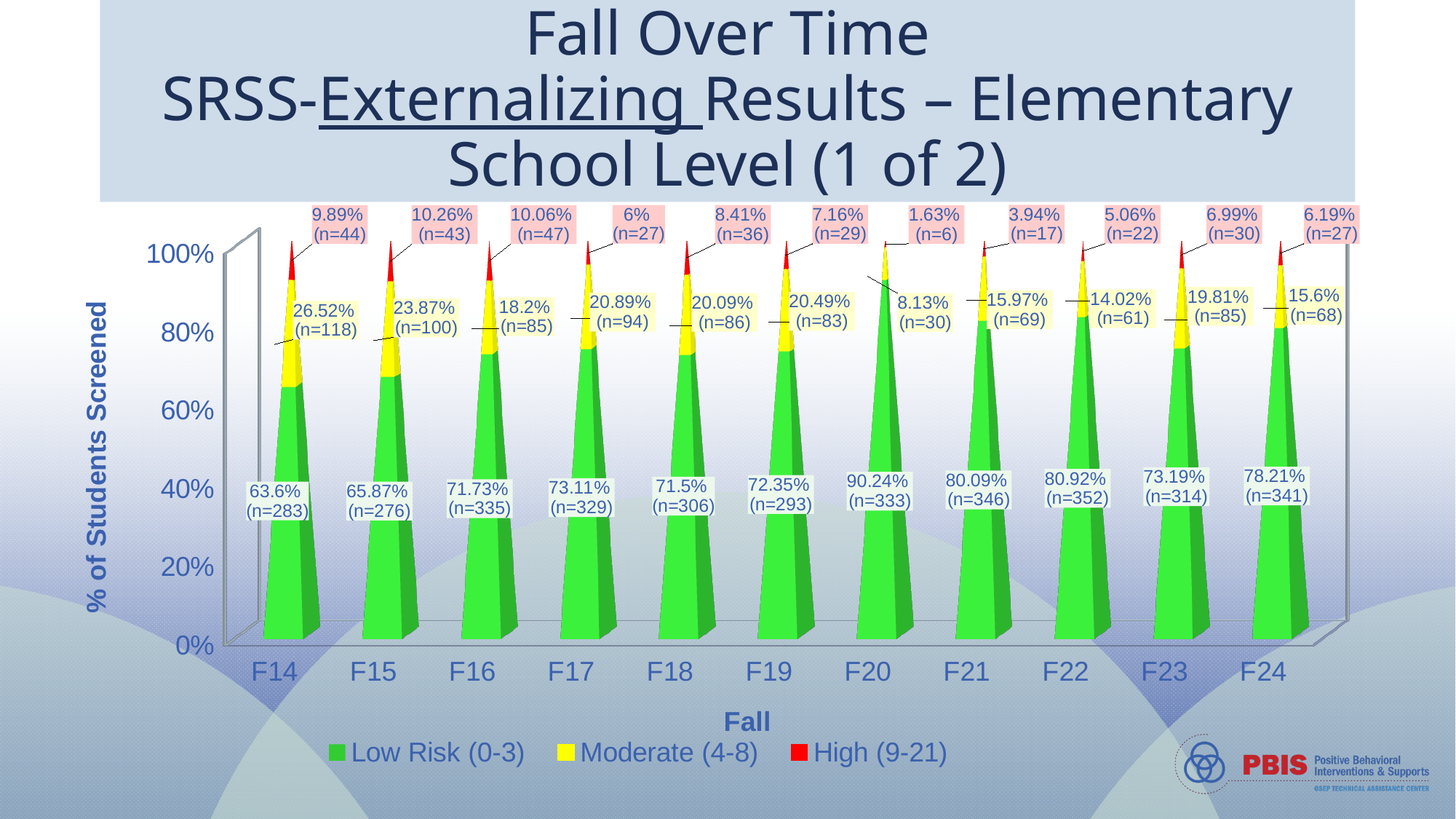
What kind of chart is shown on the slide? Stacked bar chart Which fall has the highest Low Risk (0-3) percentage? F20 Which is larger, the Moderate (4-8) percentage in F14 or in F24? F14 Overall, does the Low Risk (0-3) percentage rise or fall from F14 to F24? Rise What is the difference in percentage points between the Low Risk (0-3) value in F20 and in F14? 26.64 How many series does the legend list? 3 Which fall has the lowest Low Risk (0-3) percentage? F14 What percentage of students screened were Low Risk (0-3) in F20? 90.24% Which fall has the lowest High (9-21) percentage? F20 How many students were in the Moderate (4-8) category in F17? n=94 How many fall time points are shown on the x axis? 11 What percentage of students screened were High (9-21) in F14? 9.89%